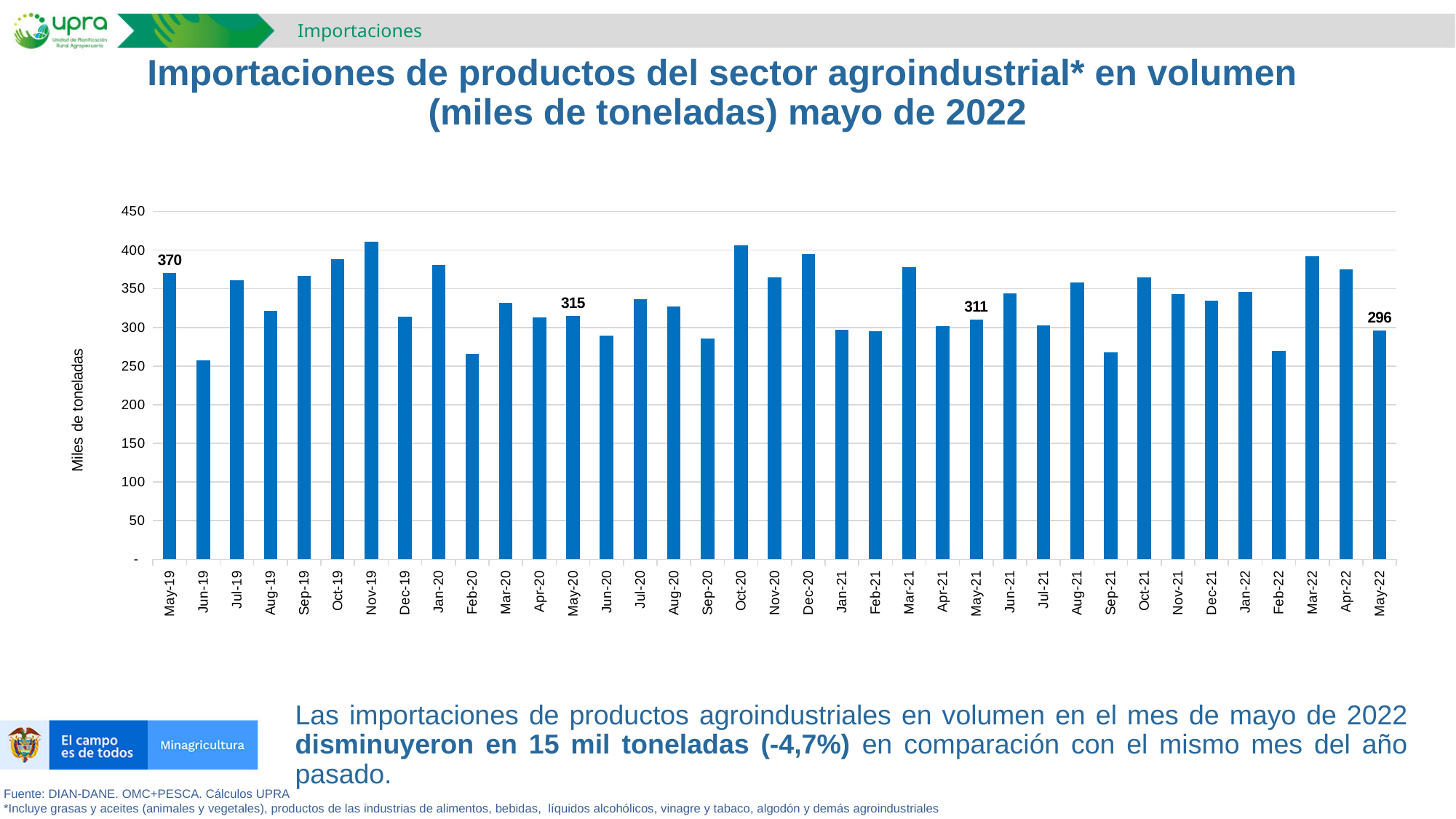
What is the value for May-21? 311 What is the label of the vertical axis? Miles de toneladas What kind of chart is shown on the slide? bar chart What is the difference between the values for May-19 and May-22? 74 How many months (bars) are shown in the chart? 37 Is the value for Jun-19 greater or less than 300? less What is the value for May-20? 315 Is the value for Nov-19 greater or less than 400? greater What is the value for May-19? 370 Which is larger, the value for May-19 or the value for May-22? May-19 What is the difference between the values for May-21 and May-22? 15 What is the value for May-22? 296